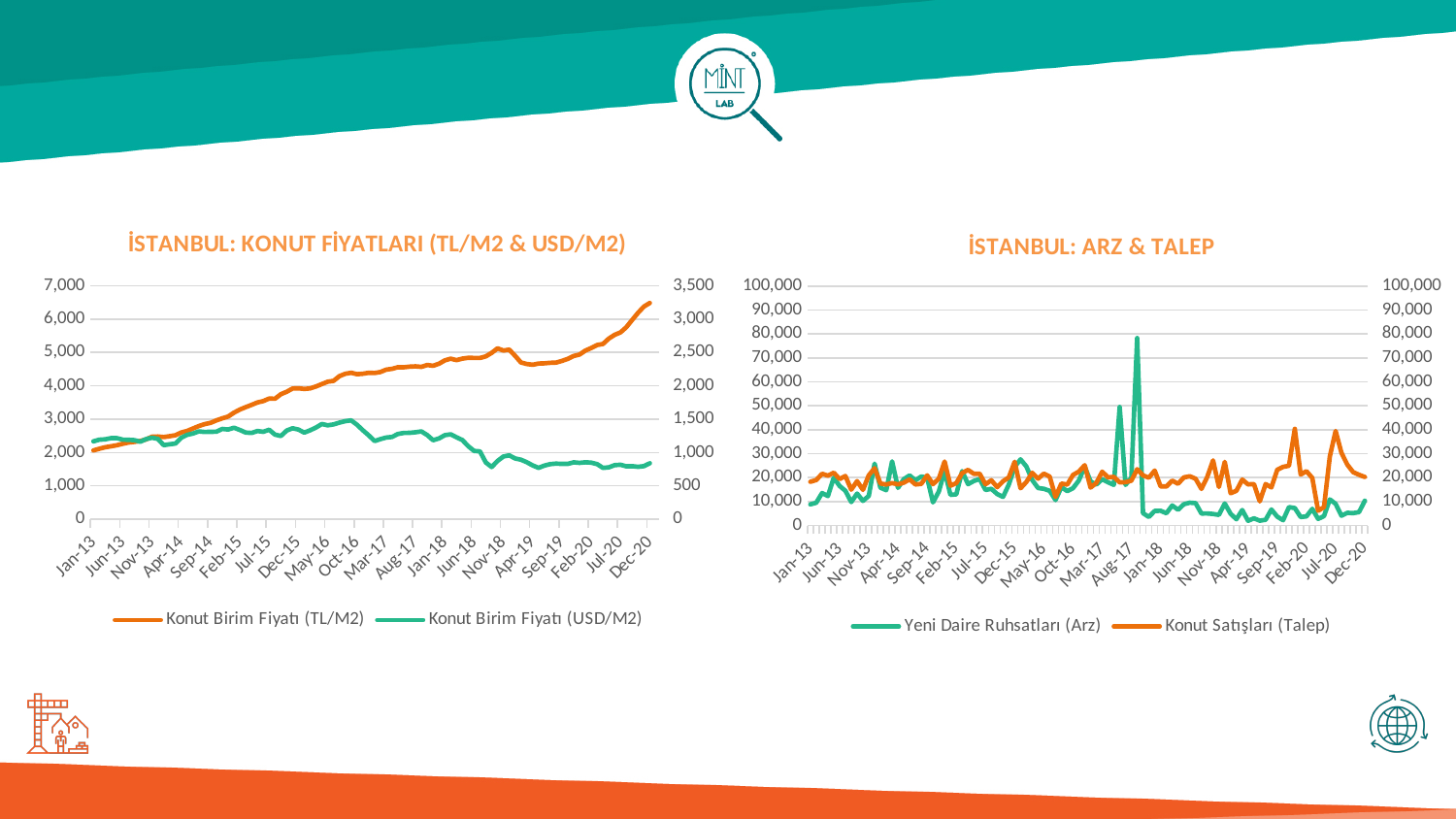
In the right chart 'İSTANBUL: ARZ & TALEP', is the highest value of Konut Satışları (Talep) greater or less than 50,000? less What kind of chart is the left chart titled 'İSTANBUL: KONUT FİYATLARI (TL/M2 & USD/M2)'? Line chart In the left chart 'İSTANBUL: KONUT FİYATLARI', how many series does the legend list? 2 In the left chart 'İSTANBUL: KONUT FİYATLARI', is the value of Konut Birim Fiyatı (TL/M2) at Jan-13 greater or less than 3,000? less In the right chart 'İSTANBUL: ARZ & TALEP', is the highest peak of Yeni Daire Ruhsatları (Arz) greater or less than 70,000? greater In the right chart 'İSTANBUL: ARZ & TALEP', how many series does the legend list? 2 In the left chart 'İSTANBUL: KONUT FİYATLARI', does the Konut Birim Fiyatı (TL/M2) series rise or fall overall from Jan-13 to Dec-20? Rise In the left chart 'İSTANBUL: KONUT FİYATLARI', which series is drawn in green? Konut Birim Fiyatı (USD/M2) In the right chart 'İSTANBUL: ARZ & TALEP', which series is drawn in orange? Konut Satışları (Talep) In the right chart 'İSTANBUL: ARZ & TALEP', what is the maximum value shown on the vertical axis? 100,000 What kind of chart is the right chart titled 'İSTANBUL: ARZ & TALEP'? Line chart